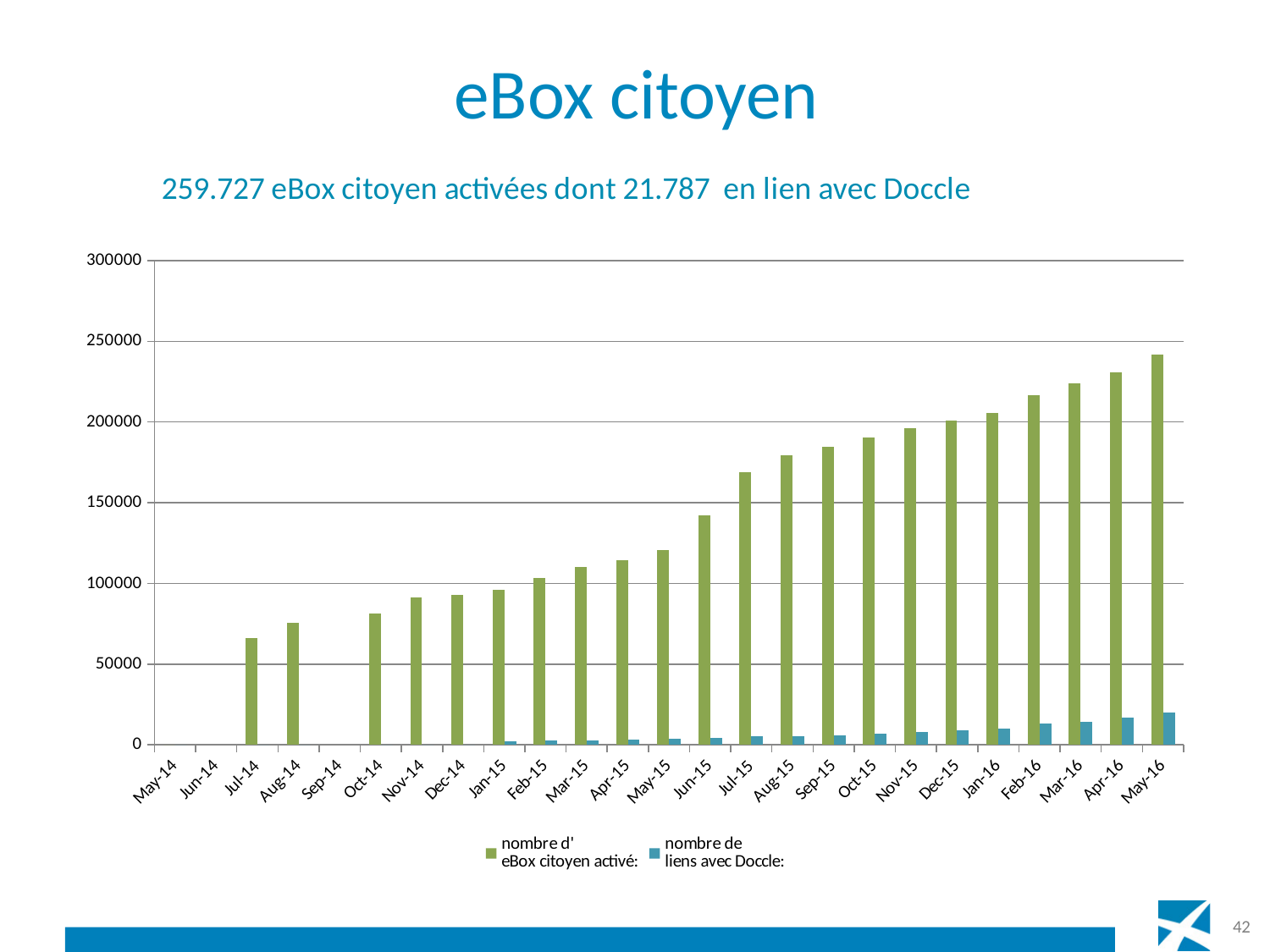
What is the title of the slide containing the chart? eBox citoyen How many series does the legend list? 2 Is the value for 'nombre d'eBox citoyen activé' in May-16 greater or less than 250000? less Do the values for 'nombre d'eBox citoyen activé' rise or fall from Jul-14 to May-16? rise Which is larger in May-16: 'nombre d'eBox citoyen activé' or 'nombre de liens avec Doccle'? nombre d'eBox citoyen activé Which month has the highest value for 'nombre d'eBox citoyen activé'? May-16 Is the value for 'nombre d'eBox citoyen activé' in Jul-14 greater or less than 50000? greater How many months are shown on the x axis? 25 What kind of chart is shown on the slide? bar chart Is the value for 'nombre d'eBox citoyen activé' in Feb-16 greater or less than 200000? greater